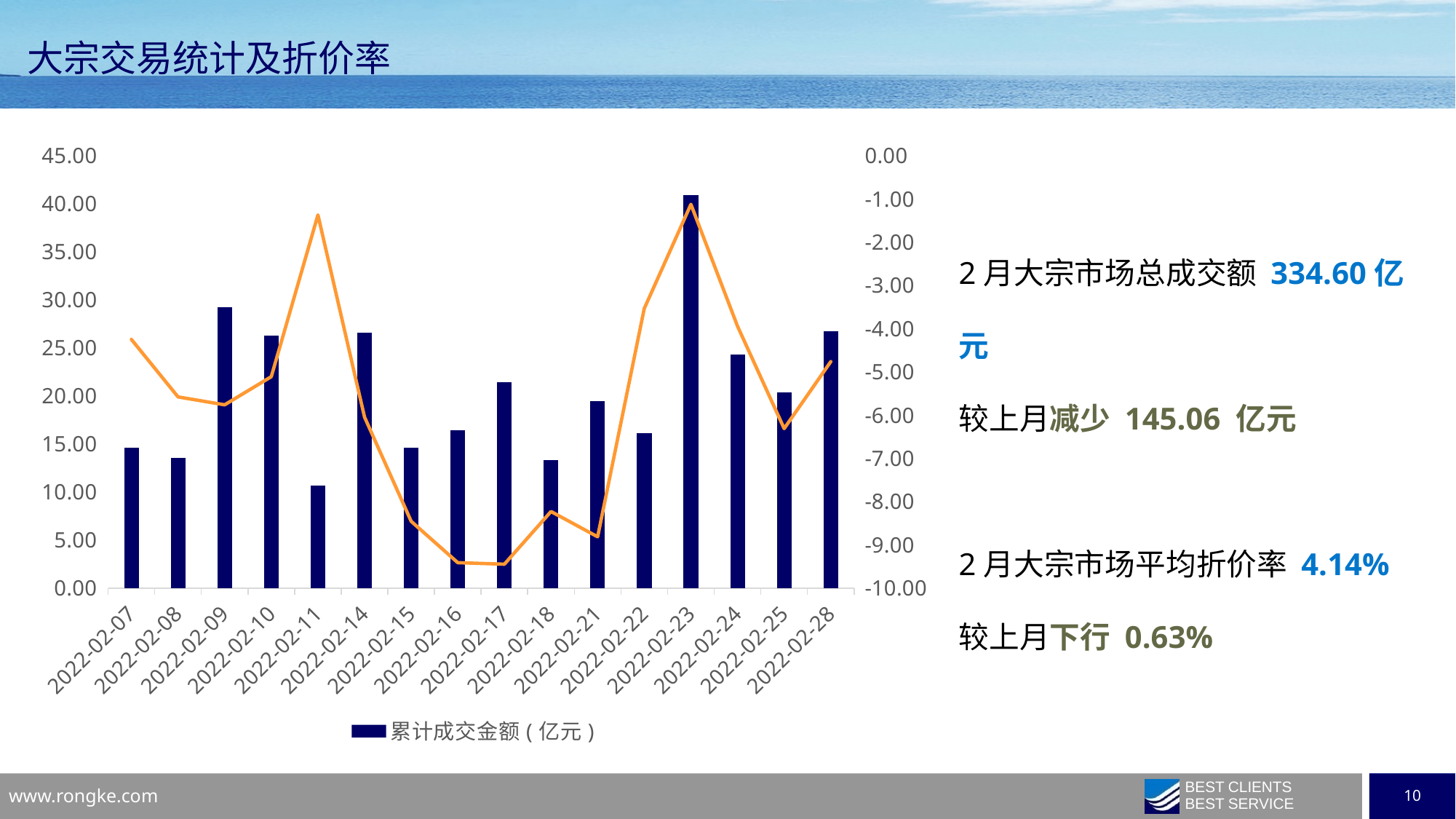
Do the bar values rise or fall from 2022-02-23 to 2022-02-25? fall Is the bar value for 2022-02-09 greater or less than 25.00? greater Which date has a taller bar, 2022-02-09 or 2022-02-10? 2022-02-09 On which date is the bar for 累计成交金额 the lowest? 2022-02-11 How many dates are shown on the x axis of the chart? 16 Is the bar value for 2022-02-11 greater or less than 15.00? less How many series does the chart legend list? 1 What is the series name shown in the chart legend? 累计成交金额（亿元） Which date has a taller bar, 2022-02-17 or 2022-02-18? 2022-02-17 Is the bar value for 2022-02-23 greater or less than 35.00? greater What kind of chart is shown on the slide? A bar chart combined with a line On which date is the bar for 累计成交金额 the highest? 2022-02-23